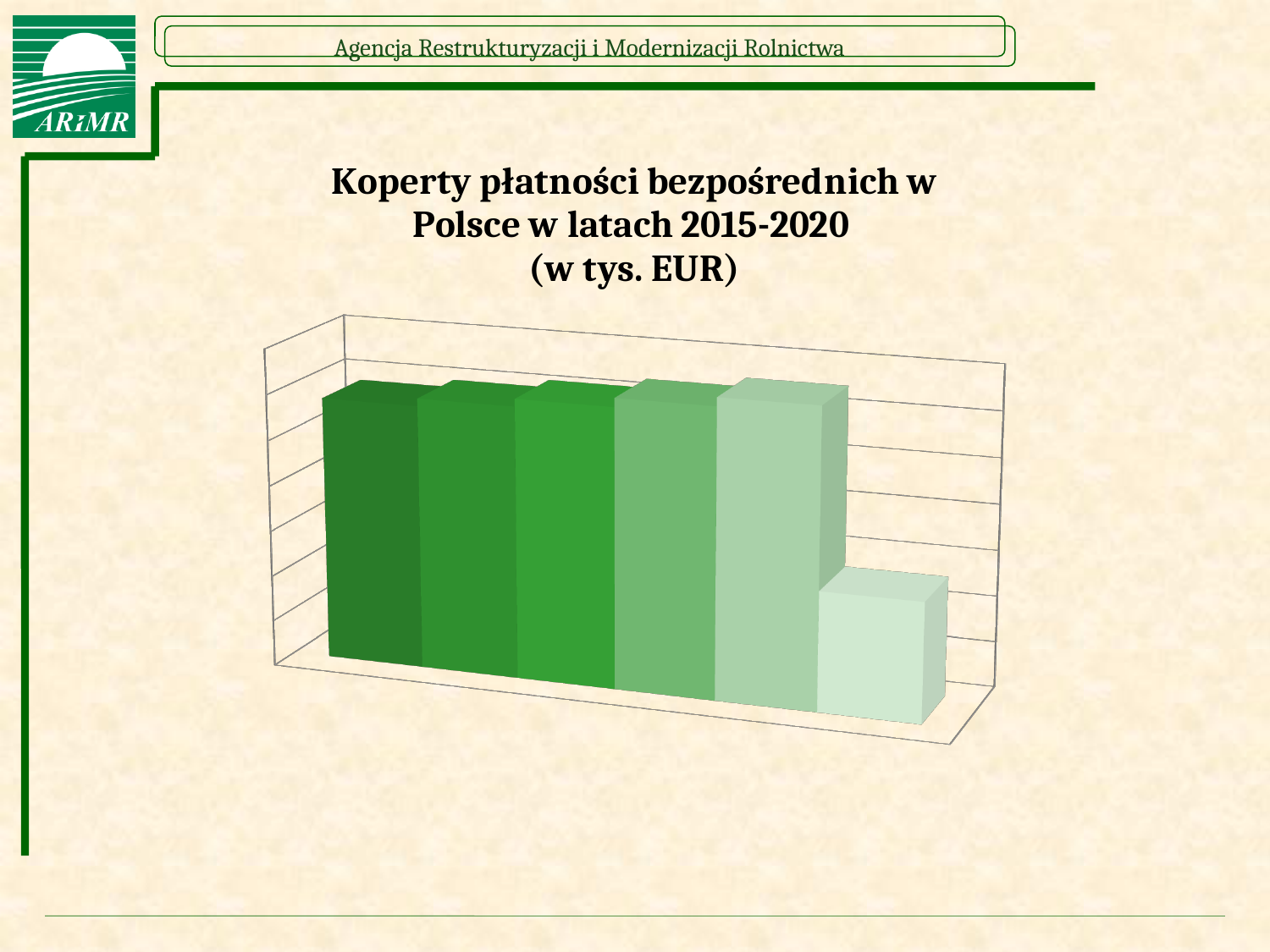
Which is larger, the leftmost bar or the rightmost bar? the leftmost bar What kind of chart is shown on the slide? bar chart How many bars are plotted in the chart? 6 Does the rightmost bar rise or fall compared with the bar immediately to its left? fall Which bar in the chart is the lowest? the rightmost (sixth) bar In what unit are the values in the chart expressed, according to the title? tys. EUR What is the title of the chart? Koperty płatności bezpośrednich w Polsce w latach 2015-2020 (w tys. EUR)